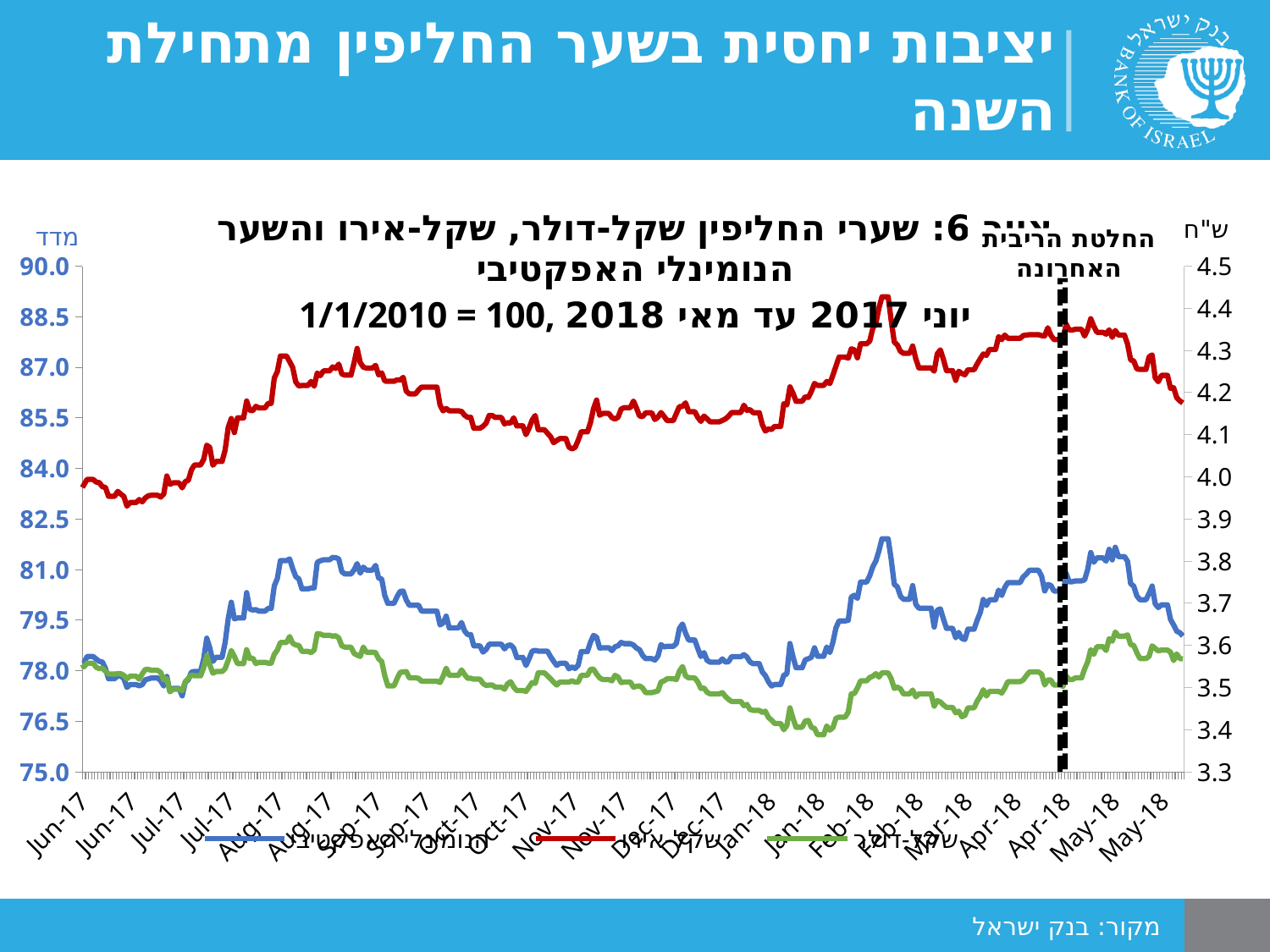
What does the vertical dashed black line on the chart mark, according to its annotation? החלטת הריבית האחרונה Is the value of the red line at its peak around Feb-18 greater or less than 4.3 on the right axis? greater How many series (lines) are plotted on the chart? 3 Is the value of the green line at its low point around Feb-18 greater or less than 3.5 on the right axis? less Which line is higher on the right axis throughout the period, the red line or the green line? the red line What kind of chart is shown on the slide? line chart Is the value of the blue line at the end of May-18 greater or less than 81.0 on the left axis? less What is the label of the left vertical axis? מדד Does the red line rise or fall between Jun-17 and Aug-17? rise Does the blue line rise or fall from its peak around Feb-18 to the end of May-18? fall